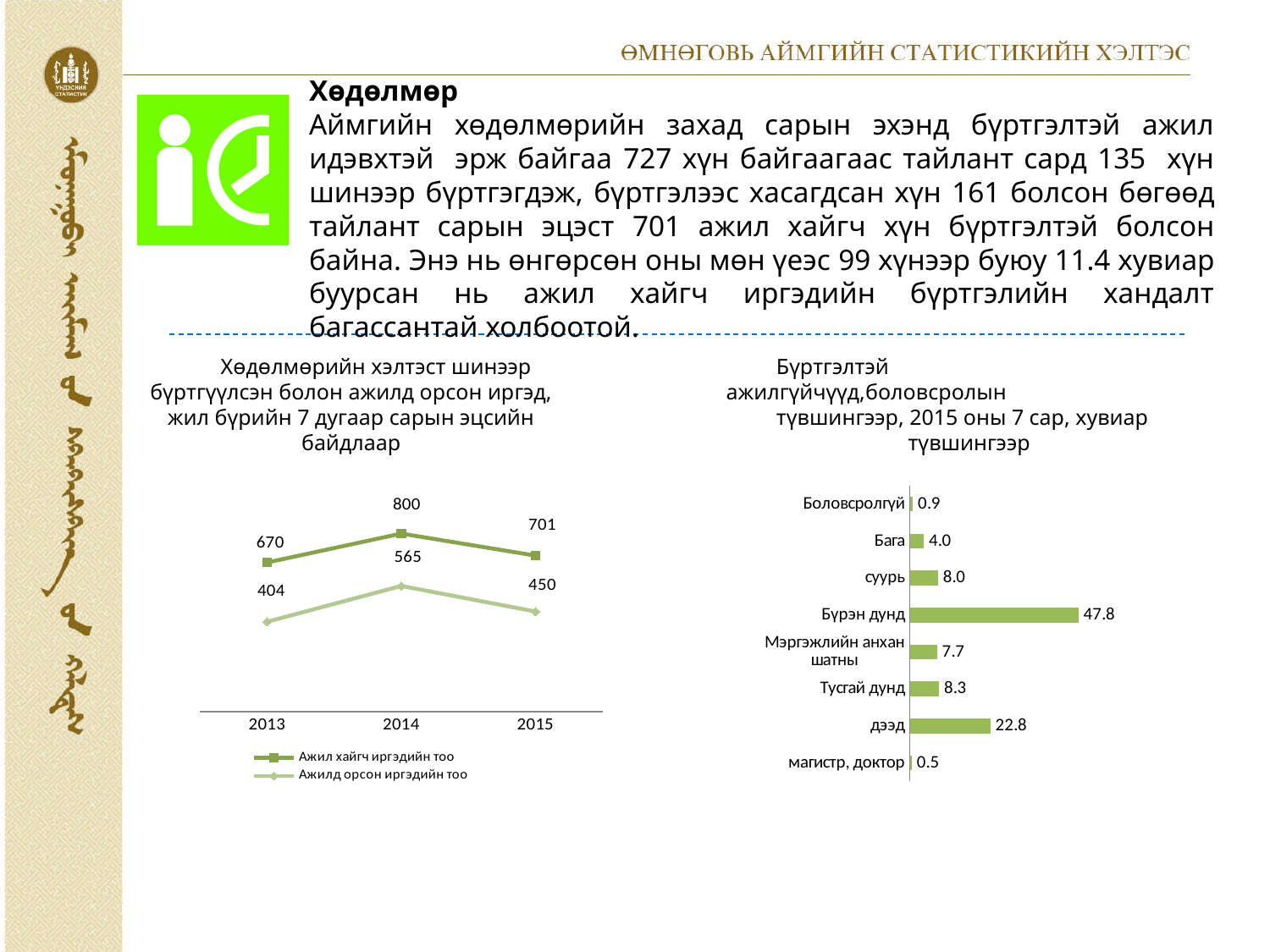
In the left chart, what is the value of Ажил хайгч иргэдийн тоо in 2014? 800 In the right chart, which category has the lowest value? магистр, доктор In the left chart, which year has the highest value for Ажилд орсон иргэдийн тоо? 2014 In the right chart, what is the difference between дээд and суурь? 14.8 In the left chart, does Ажил хайгч иргэдийн тоо rise or fall from 2014 to 2015? Fall In the right chart, what is the value for Бүрэн дунд? 47.8 In the left chart, how many series does the legend list? 2 What kind of chart is the left chart? Line chart In the right chart, how many categories are shown? 8 In the left chart, what is the value of Ажилд орсон иргэдийн тоо in 2013? 404 In the left chart, what is the difference between Ажил хайгч иргэдийн тоо and Ажилд орсон иргэдийн тоо in 2015? 251 In the right chart, which is larger: Тусгай дунд or Мэргэжлийн анхан шатны? Тусгай дунд